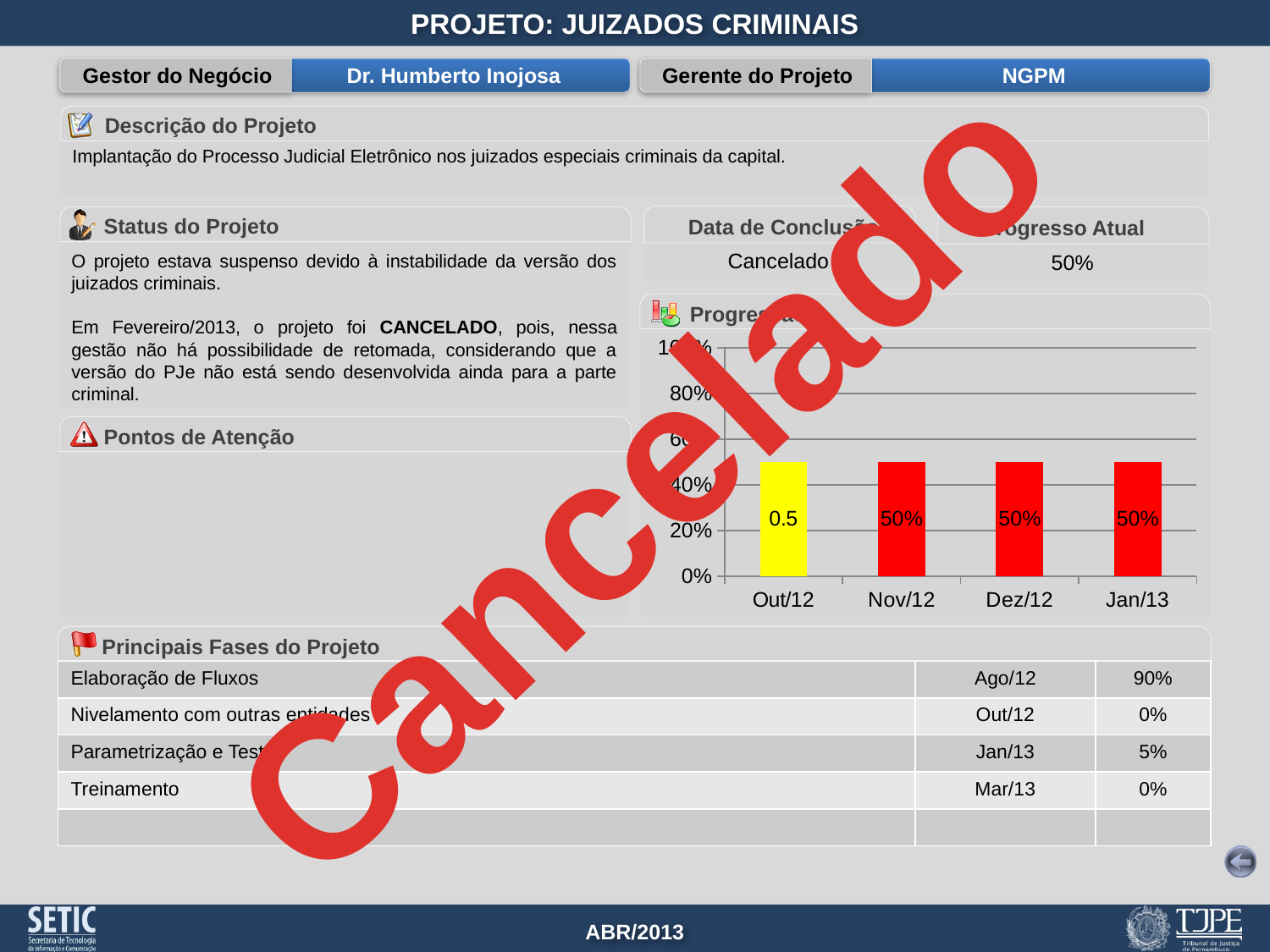
What value is labelled on the bar for Jan/13? 50% Do the bar values rise, fall, or stay flat from Nov/12 to Jan/13? stay flat What value is labelled on the bar for Out/12? 0.5 What kind of chart is shown on the slide? bar chart Is the value for Nov/12 greater or less than 80%? less Is the value for Jan/13 greater or less than 20%? greater What value is labelled on the bar for Nov/12? 50% What value is labelled on the bar for Dez/12? 50% What colour are the bars for Nov/12, Dez/12 and Jan/13? red What colour is the bar for Out/12? yellow What is the difference between the values for Dez/12 and Nov/12? 0% How many categories are shown on the x axis of the chart? 4